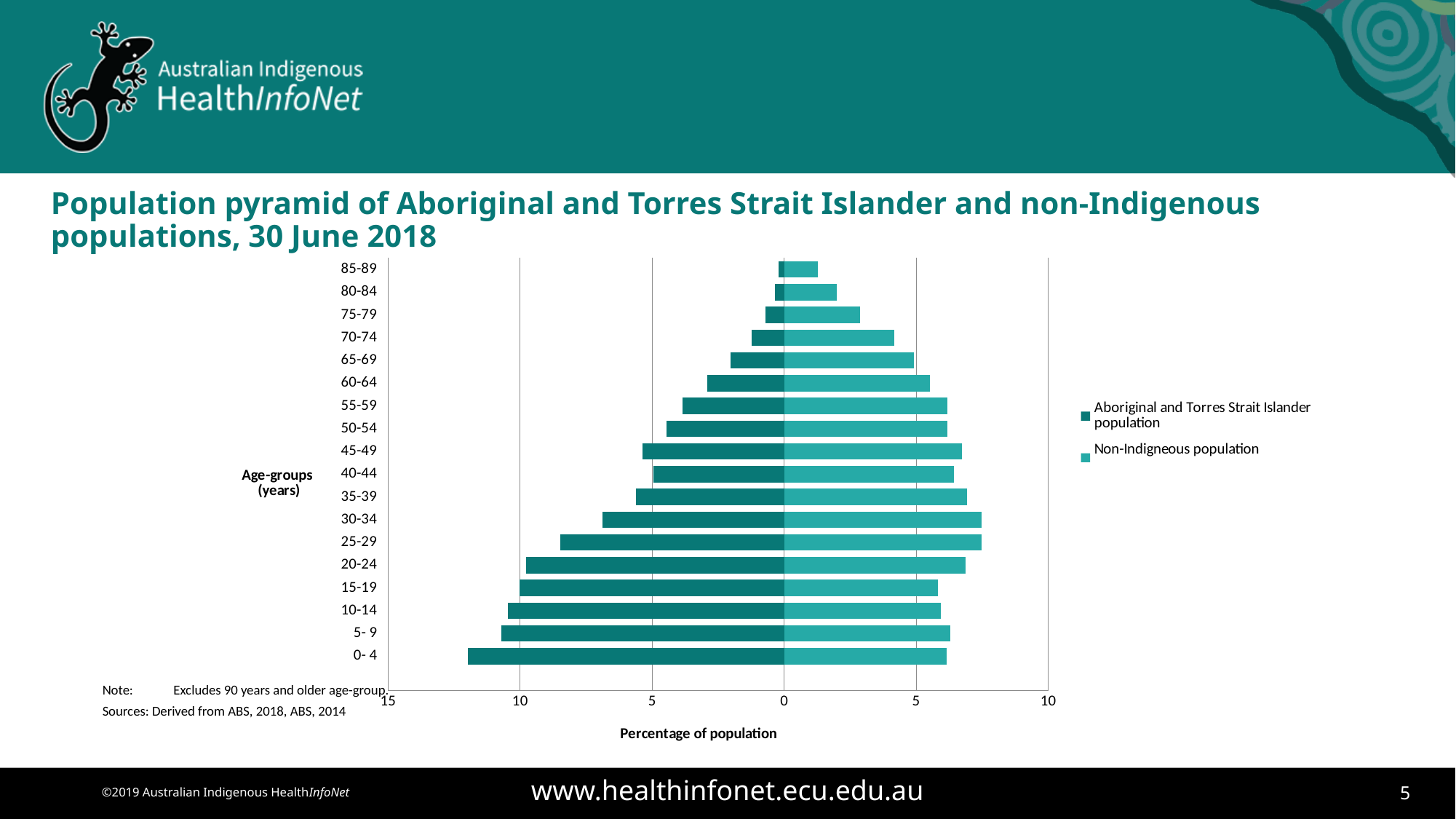
Is the value for the Non-Indigenous population in the 30-34 age group greater or less than 5? greater How many series does the legend list? 2 Which age group has the lowest value for the Aboriginal and Torres Strait Islander population? 85-89 For the 65-69 age group, which series has the larger value: Aboriginal and Torres Strait Islander population or Non-Indigenous population? Non-Indigenous population Is the value for the Aboriginal and Torres Strait Islander population in the 0- 4 age group greater or less than 10? greater For the 0- 4 age group, which series has the larger value: Aboriginal and Torres Strait Islander population or Non-Indigenous population? Aboriginal and Torres Strait Islander population What is the title of the horizontal axis of the chart? Percentage of population Which age group has the highest value for the Aboriginal and Torres Strait Islander population? 0- 4 What kind of chart is shown on the slide? bar chart Is the value for the Aboriginal and Torres Strait Islander population in the 60-64 age group greater or less than 5? less Which age group has the lowest value for the Non-Indigenous population? 85-89 How many age-group categories are plotted on the chart? 18